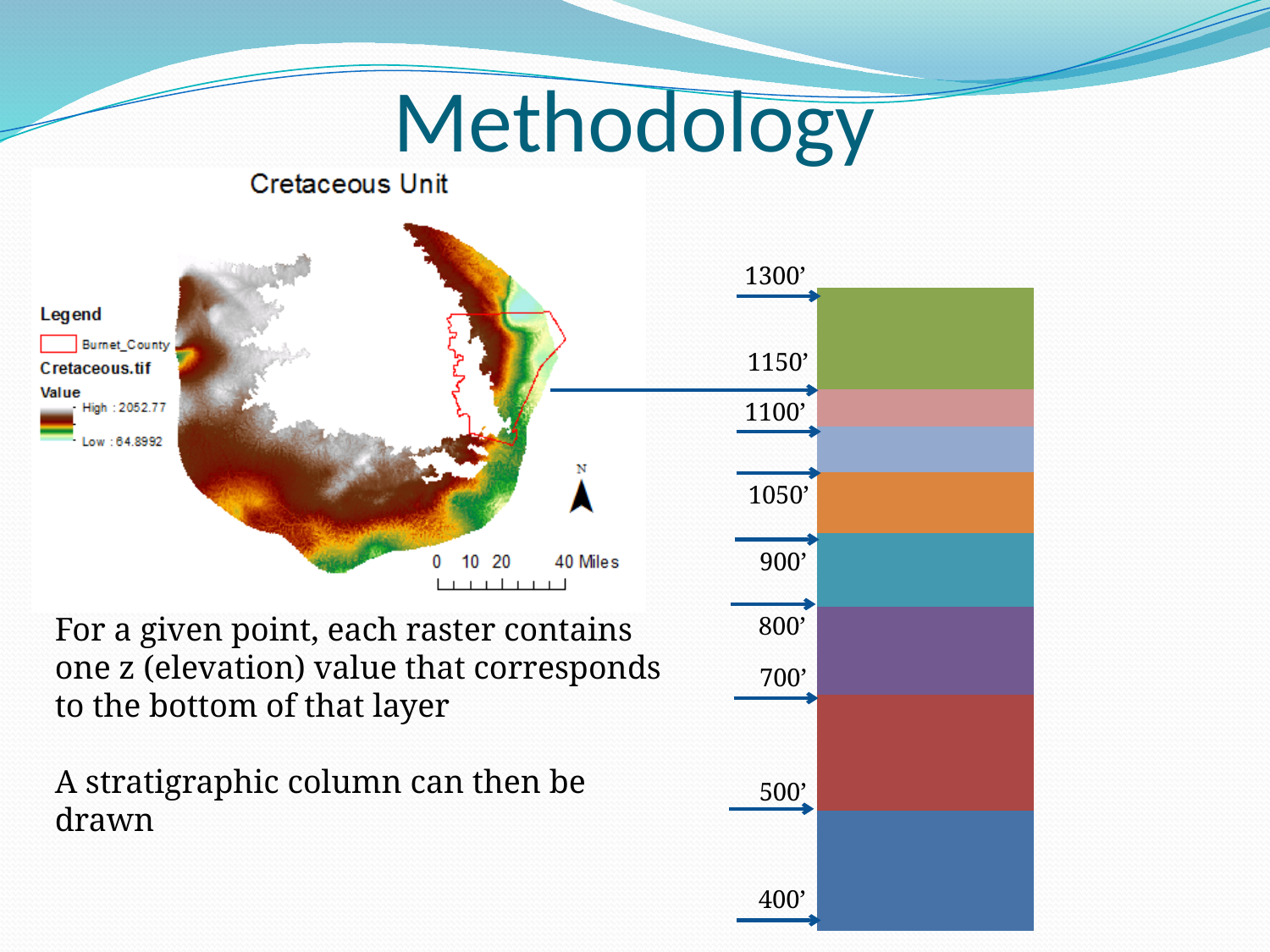
How many colored layers make up the stratigraphic column? 8 What is the lowest elevation label shown on the stratigraphic column? 400' On the map legend, what is the High value for Cretaceous.tif? 2052.77 Which is larger on the stratigraphic column, the 1050' label or the 900' label? 1050' What is the highest elevation label shown on the stratigraphic column? 1300' What is the difference between the 1300' and 1150' labels on the stratigraphic column? 150' What color is the topmost layer of the stratigraphic column? green Do the elevation labels on the stratigraphic column increase or decrease from bottom to top? increase On the map legend, what is the Low value for Cretaceous.tif? 64.8992 What is the difference between the 500' and 400' labels on the stratigraphic column? 100' What is the title of the map on the left of the slide? Cretaceous Unit What is the difference between the top elevation label (1300') and the bottom elevation label (400') on the stratigraphic column? 900'